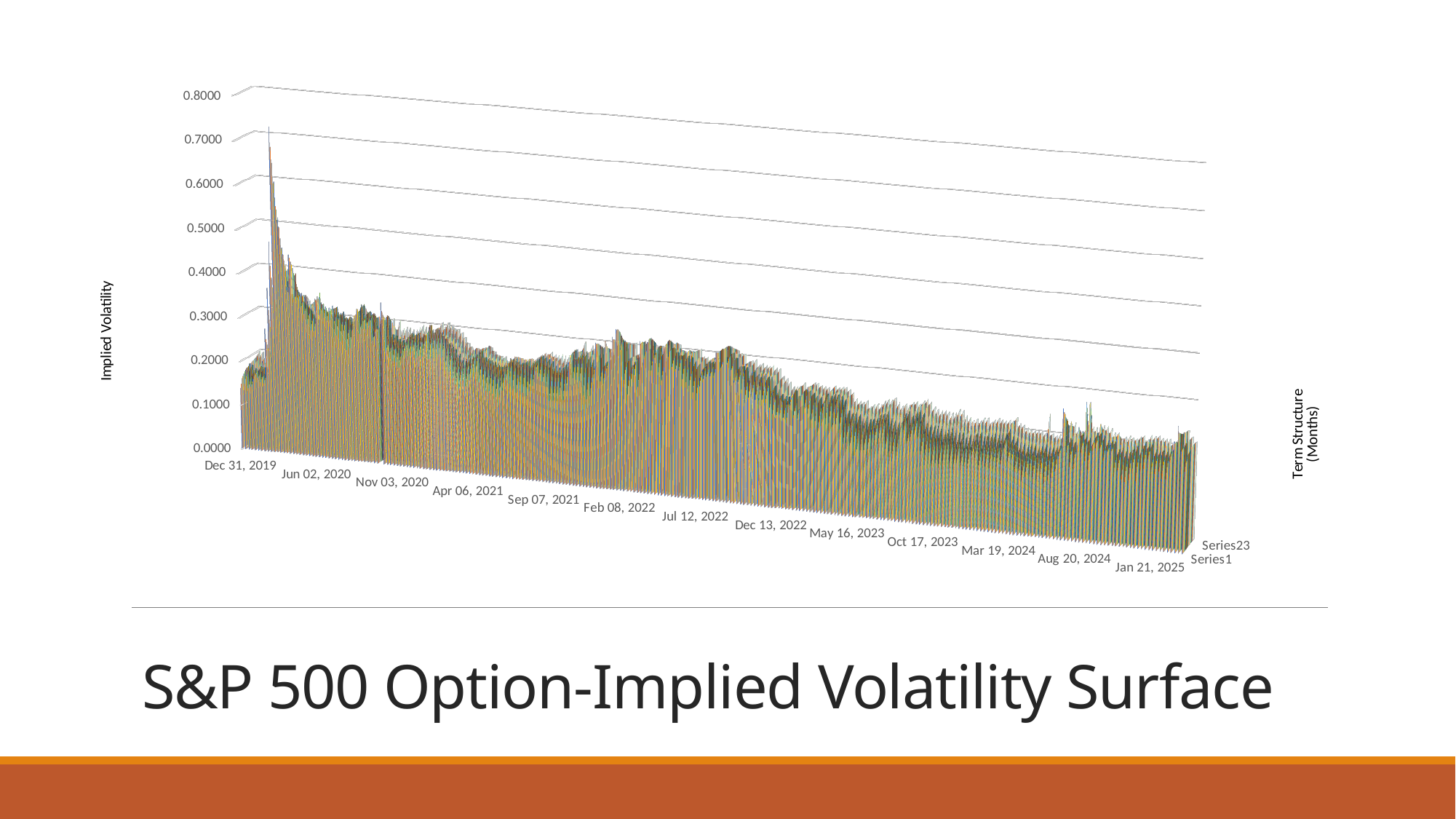
Overall, does implied volatility rise or fall from early 2020 to Jan 21, 2025? fall Is the implied volatility around Jan 21, 2025 greater or less than 0.4000? less Is the implied volatility around Dec 31, 2019 greater or less than 0.4000? less Which period shows higher implied volatility: early 2020 or Aug 20, 2024? early 2020 What kind of chart is shown on the slide? 3D surface chart Is the peak implied volatility reached in early 2020 greater or less than 0.5000? greater How many date labels are shown along the x axis? 13 What is the title of the slide's chart? S&P 500 Option-Implied Volatility Surface What is the title of the depth axis labelled Series1 to Series23? Term Structure (Months)